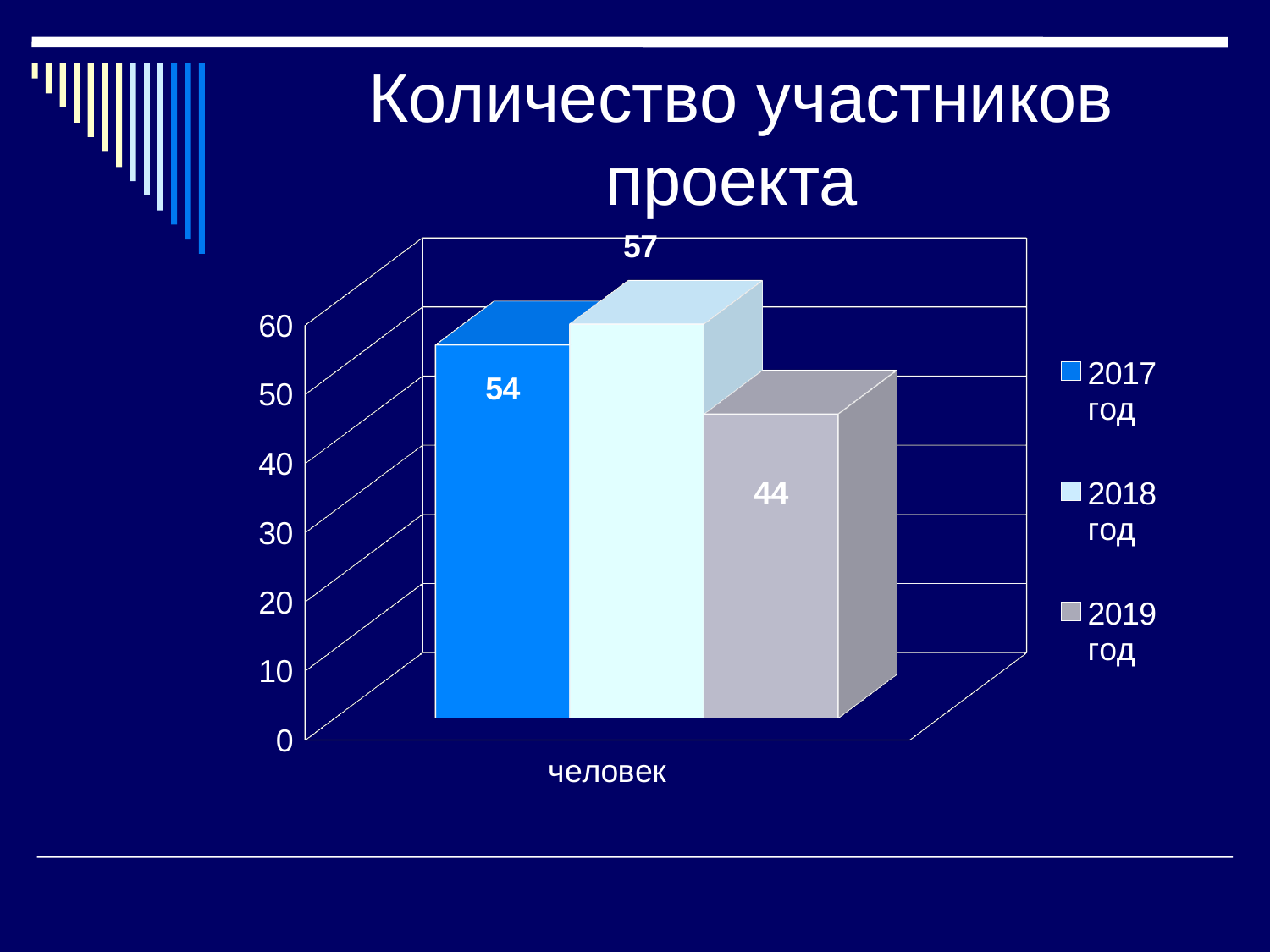
Which year has the lowest number of participants? 2019 год What is the difference between the values for 2018 год and 2019 год? 13 What is the title of the chart? Количество участников проекта Which year has the highest number of participants? 2018 год What is the label shown on the x axis of the chart? человек What is the value for 2017 год? 54 Which is larger, the value for 2017 год or the value for 2019 год? 2017 год How many series does the legend list? 3 What is the difference between the values for 2017 год and 2019 год? 10 What is the value for 2018 год? 57 What kind of chart is shown on the slide? bar chart What is the value for 2019 год? 44